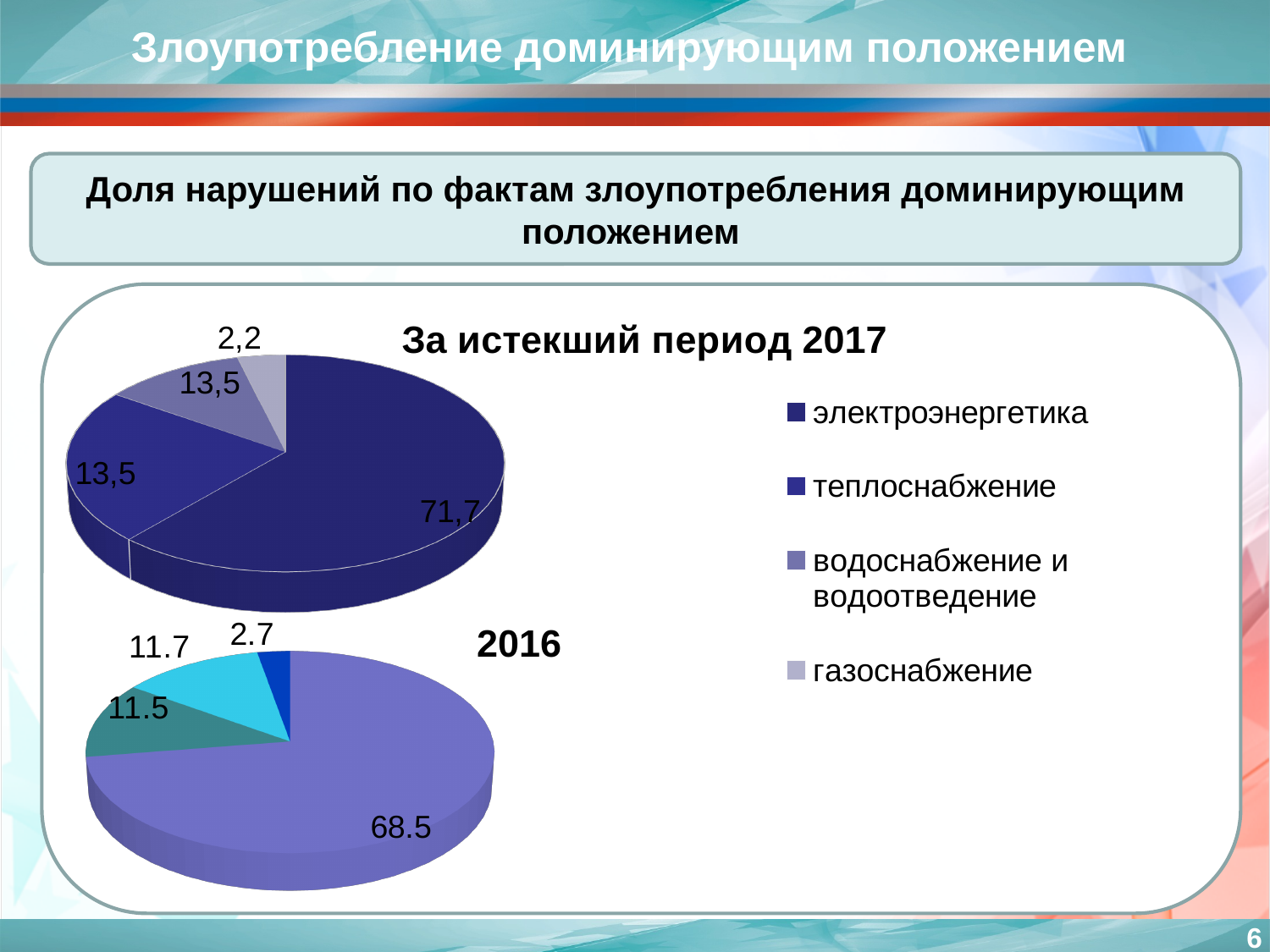
In the chart titled "2016", what is the value of the smallest slice? 2.7 In the chart titled "За истекший период 2017", what is the value shown for теплоснабжение? 13,5 In the chart titled "За истекший период 2017", which category has the largest slice? электроэнергетика In the chart titled "За истекший период 2017", what is the difference between the values for электроэнергетика and газоснабжение? 69,5 Which chart has the larger value for its biggest slice, "За истекший период 2017" or "2016"? За истекший период 2017 In the chart titled "За истекший период 2017", what is the value shown for газоснабжение? 2,2 How many entries does the legend on the slide list? 4 In the chart titled "За истекший период 2017", which category has the smallest slice? газоснабжение How many slices does the chart titled "2016" have? 4 In the chart titled "2016", what is the value of the largest slice? 68.5 In the chart titled "За истекший период 2017", what is the value shown for электроэнергетика? 71,7 What kind of chart is the chart titled "За истекший период 2017"? pie chart